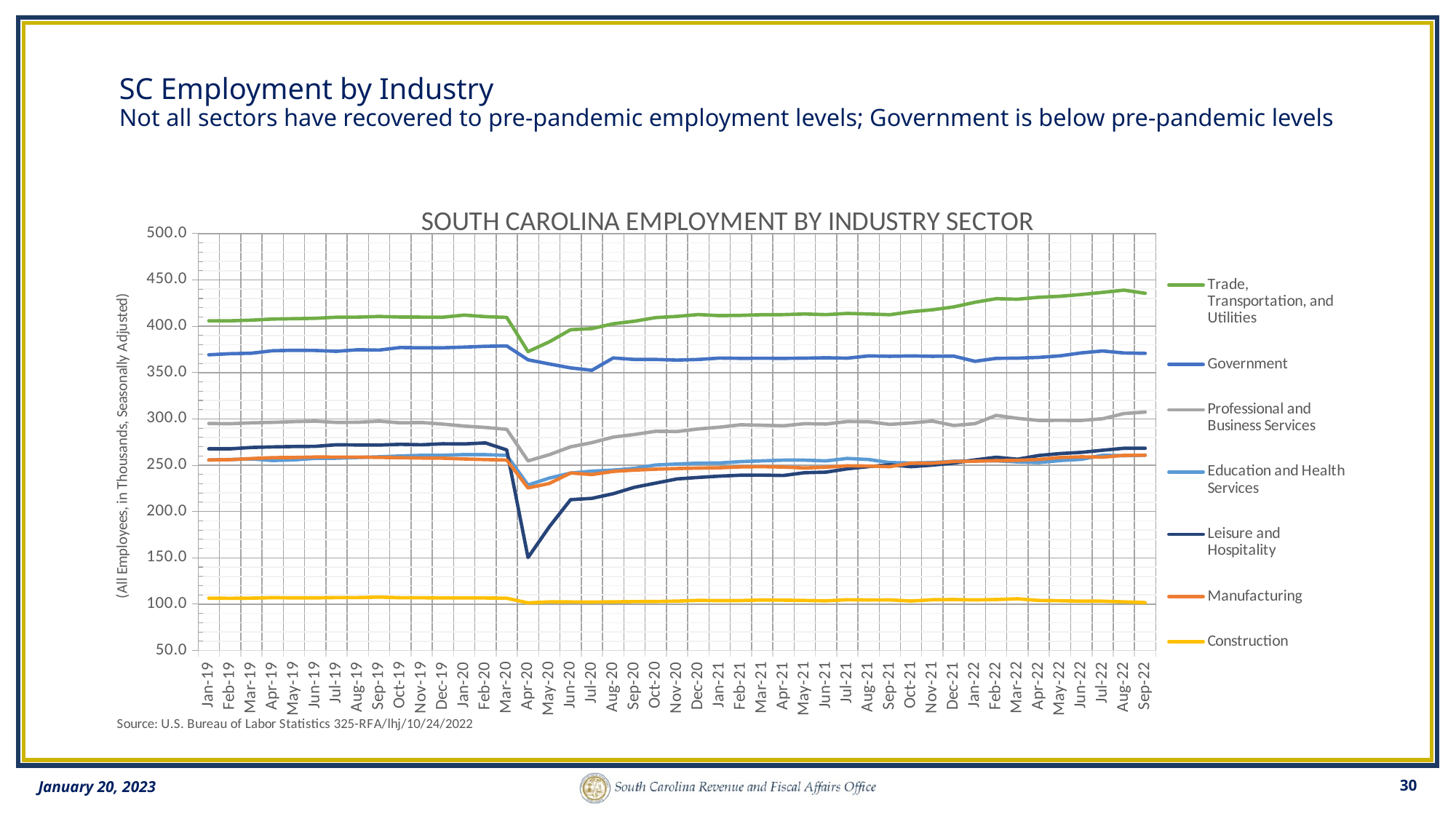
Is the value for Trade, Transportation, and Utilities in Sep-22 greater or less than 400.0? greater What is the title of the chart? SOUTH CAROLINA EMPLOYMENT BY INDUSTRY SECTOR What kind of chart is shown on the slide? line chart How many series does the legend list? 7 Which industry sector has the highest employment across the whole period? Trade, Transportation, and Utilities Does Leisure and Hospitality employment rise or fall from Apr-20 to Sep-22? rise Which industry sector has the lowest employment across the whole period? Construction Is the value for Government in Jan-19 greater or less than 350.0? greater In Sep-22, which is larger: Government or Professional and Business Services? Government Is the value for Construction in Sep-22 greater or less than 150.0? less Which series shows the sharpest drop in Apr-20? Leisure and Hospitality